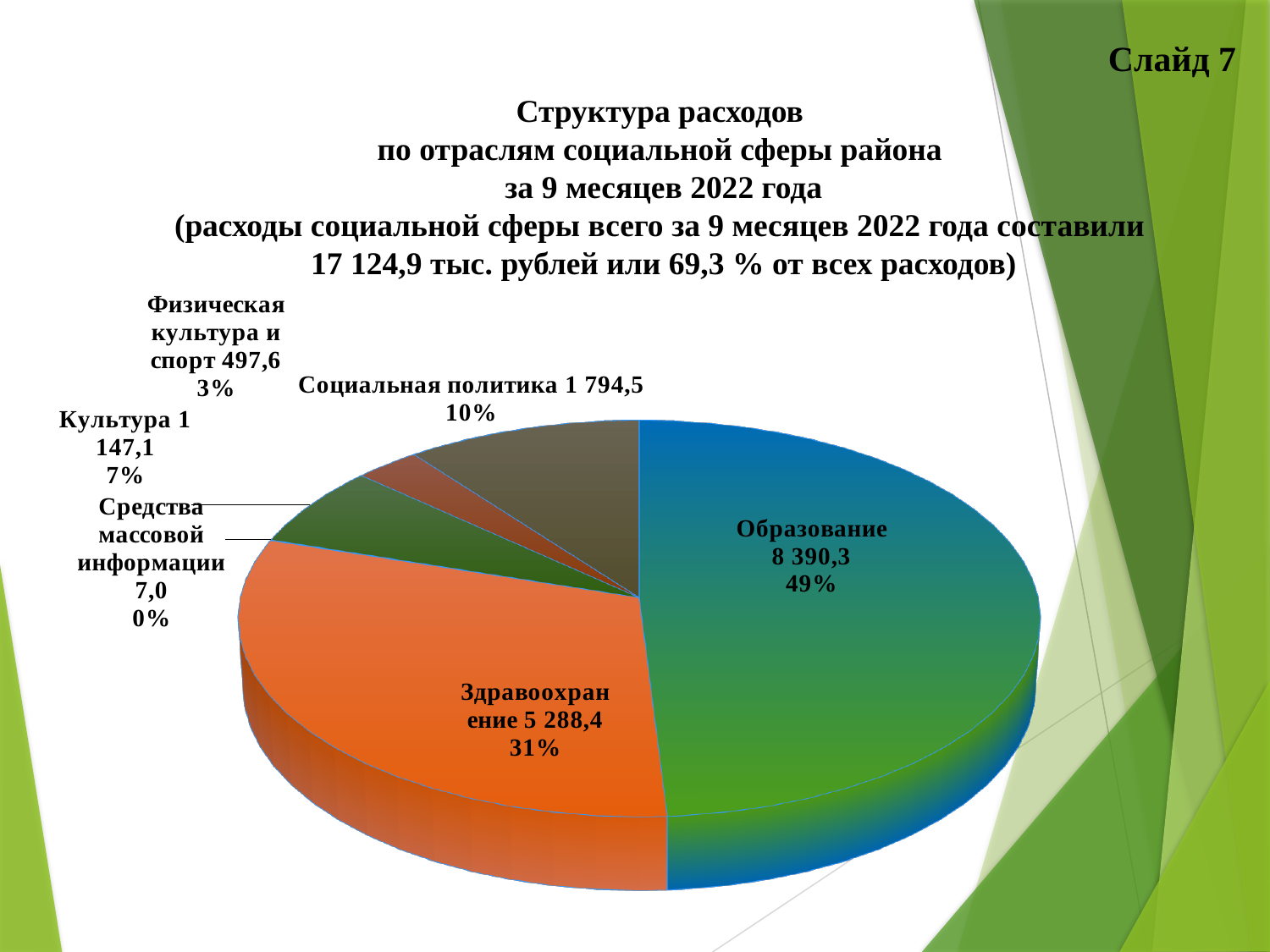
What is the value shown for Социальная политика? 1 794,5 What is the value shown for Средства массовой информации? 7,0 What share of the pie does Здравоохранение account for? 31% What is the difference between the percentage shares of Образование and Здравоохранение? 18% Which category has the smallest slice of the pie? Средства массовой информации What is the value shown for Физическая культура и спорт? 497,6 Which is larger, the value for Здравоохранение or the value for Социальная политика? Здравоохранение What is the value shown for Образование? 8 390,3 What share of the pie does Культура account for? 7% What kind of chart is shown on the slide? pie chart How many categories (slices) does the pie chart have? 6 Which category has the largest slice of the pie? Образование